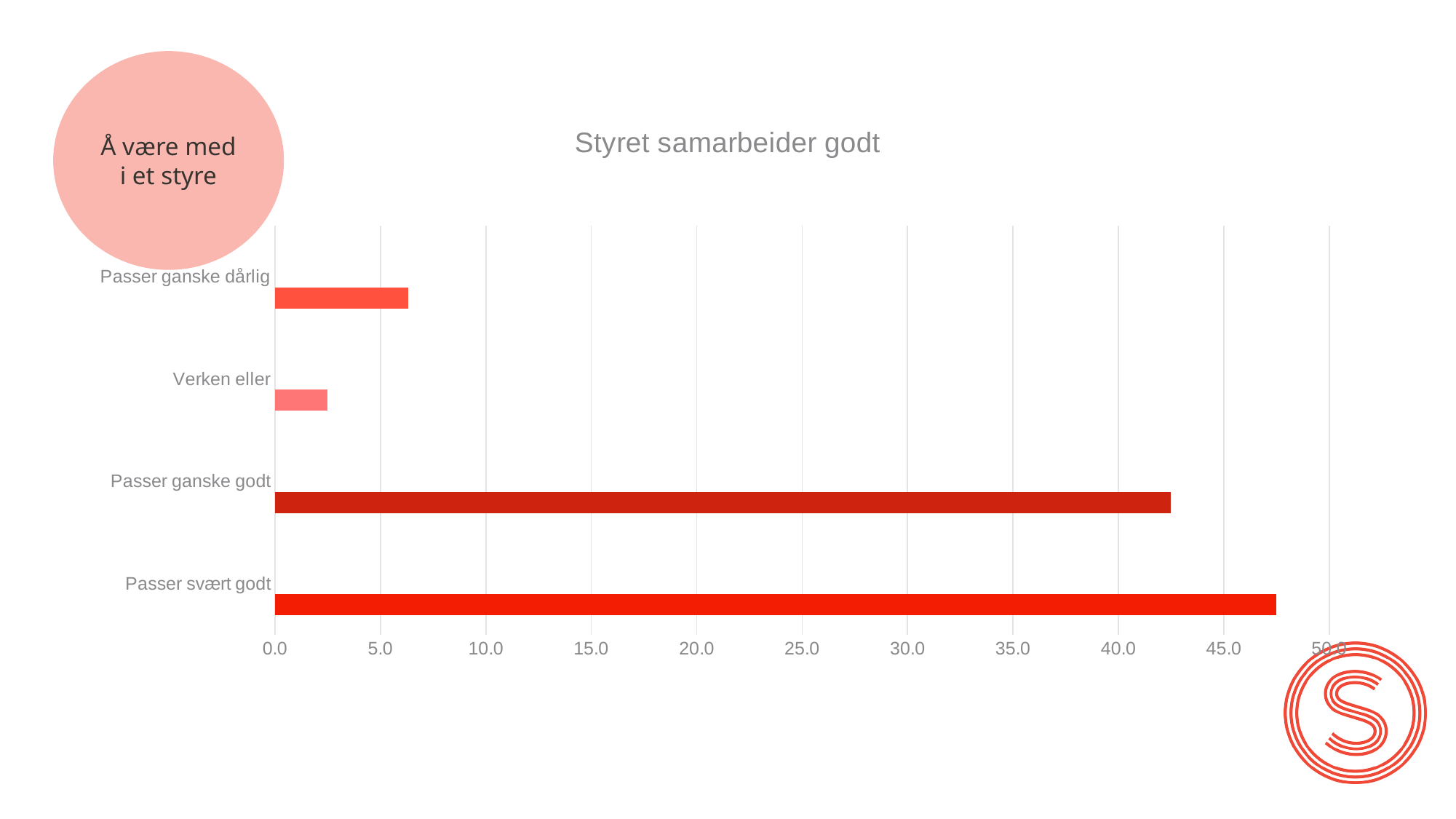
Is the value for Verken eller greater or less than 5.0? less Which is larger, the value for Passer ganske godt or the value for Passer ganske dårlig? Passer ganske godt What is the highest value shown on the x axis? 50.0 Is the value for Passer svært godt greater or less than 45.0? greater Is the value for Passer ganske godt greater or less than 40.0? greater What kind of chart is shown on the slide? bar chart Which is larger, the value for Verken eller or the value for Passer ganske dårlig? Passer ganske dårlig What is the title of the chart? Styret samarbeider godt Which category has the lowest value? Verken eller How many categories are plotted in the chart? 4 Which category has the highest value? Passer svært godt